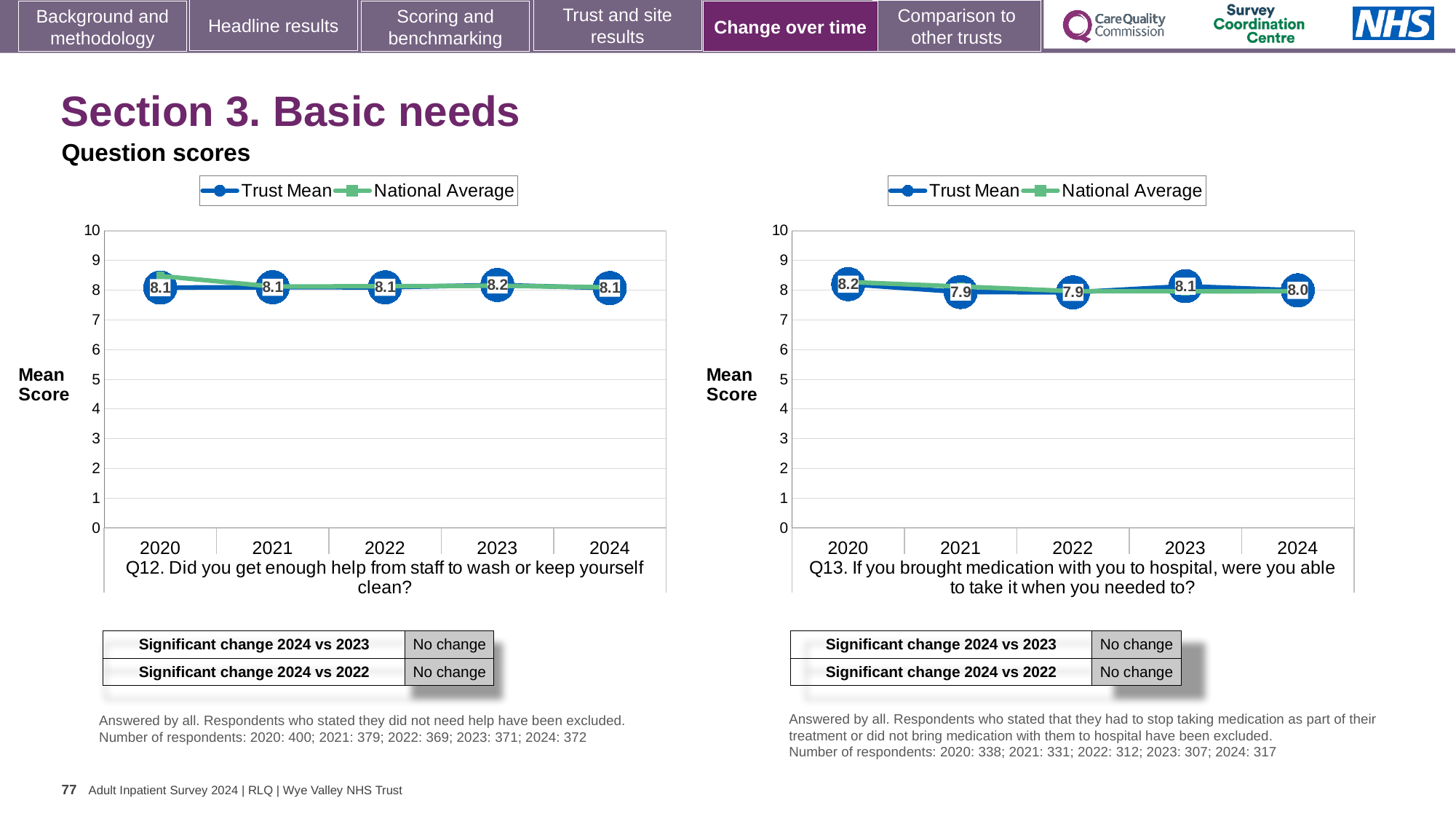
In the Q13 chart (right), what is the difference between the Trust Mean scores for 2020 and 2021? 0.3 In the Q13 chart (right), which year has the highest Trust Mean score? 2020 In the Q13 chart (right), is the Trust Mean score higher in 2020 or in 2024? 2020 In the Q13 chart (right), what is the Trust Mean score for 2021? 7.9 How many years are plotted on the x axis of the Q12 chart (left)? 5 What type of chart is used for the Q12 chart (left)? Line chart In the Q12 chart (left), which year has the highest Trust Mean score? 2023 In the Q13 chart (right), what is the Trust Mean score for 2024? 8.0 In the Q12 chart (left), what is the Trust Mean score for 2023? 8.2 In the Q12 chart (left), is the National Average for 2020 greater or less than 8? greater In the Q13 chart (right), does the Trust Mean rise or fall from 2020 to 2021? Fall How many series does the legend of the Q13 chart (right) list? 2